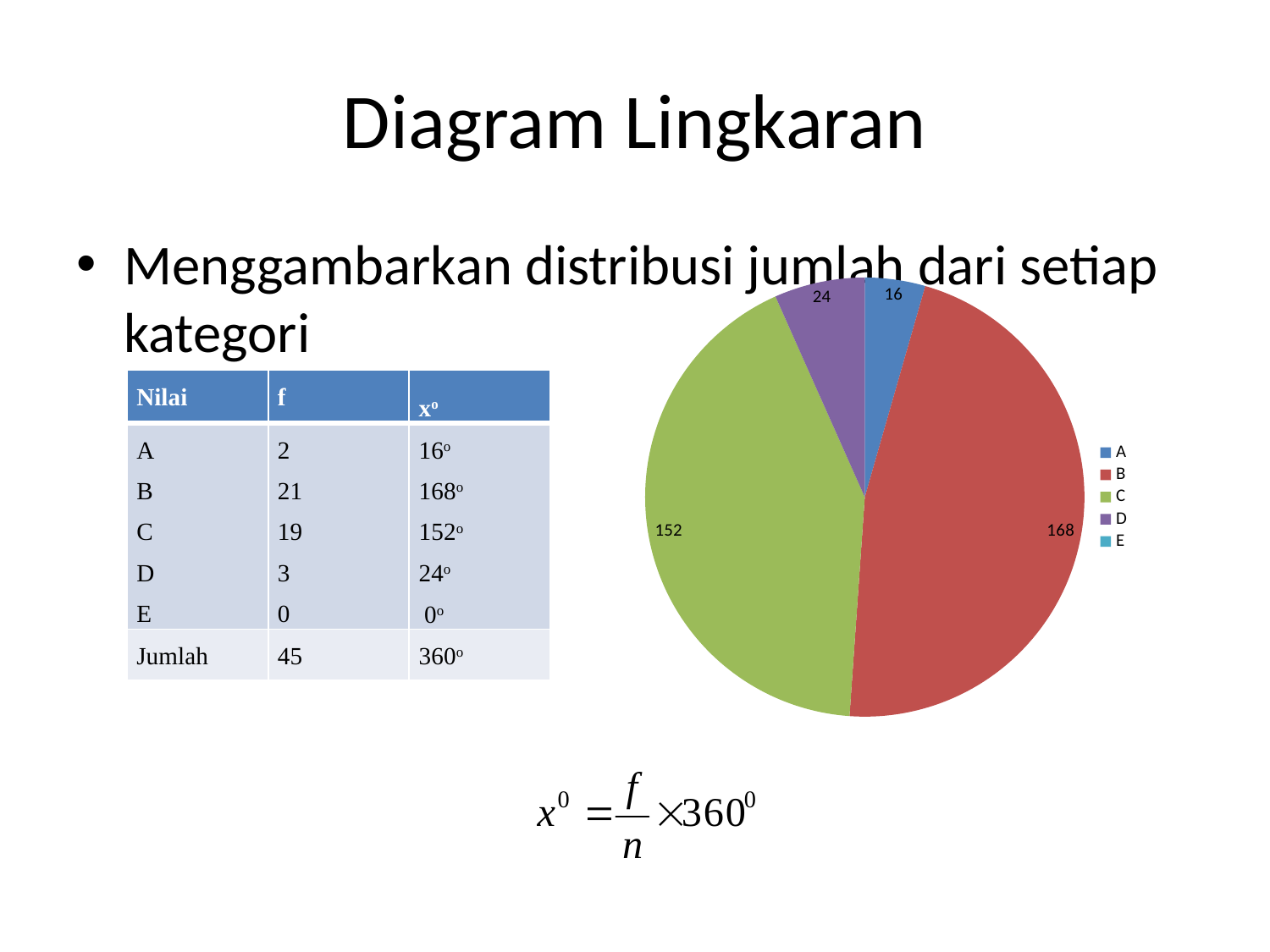
What is the value shown for slice A in the pie chart? 16 What colour is the slice for category C in the pie chart? green What is the value shown for slice B in the pie chart? 168 Among the slices with labels shown, which category has the smallest slice? A What is the difference between the values for D and A in the pie chart? 8 What is the difference between the values for B and C in the pie chart? 16 What is the value shown for slice D in the pie chart? 24 Which category has the largest slice in the pie chart? B Which is larger in the pie chart, the slice for C or the slice for D? C What is the value shown for slice C in the pie chart? 152 How many entries does the legend of the pie chart list? 5 What type of chart is shown on the slide? pie chart